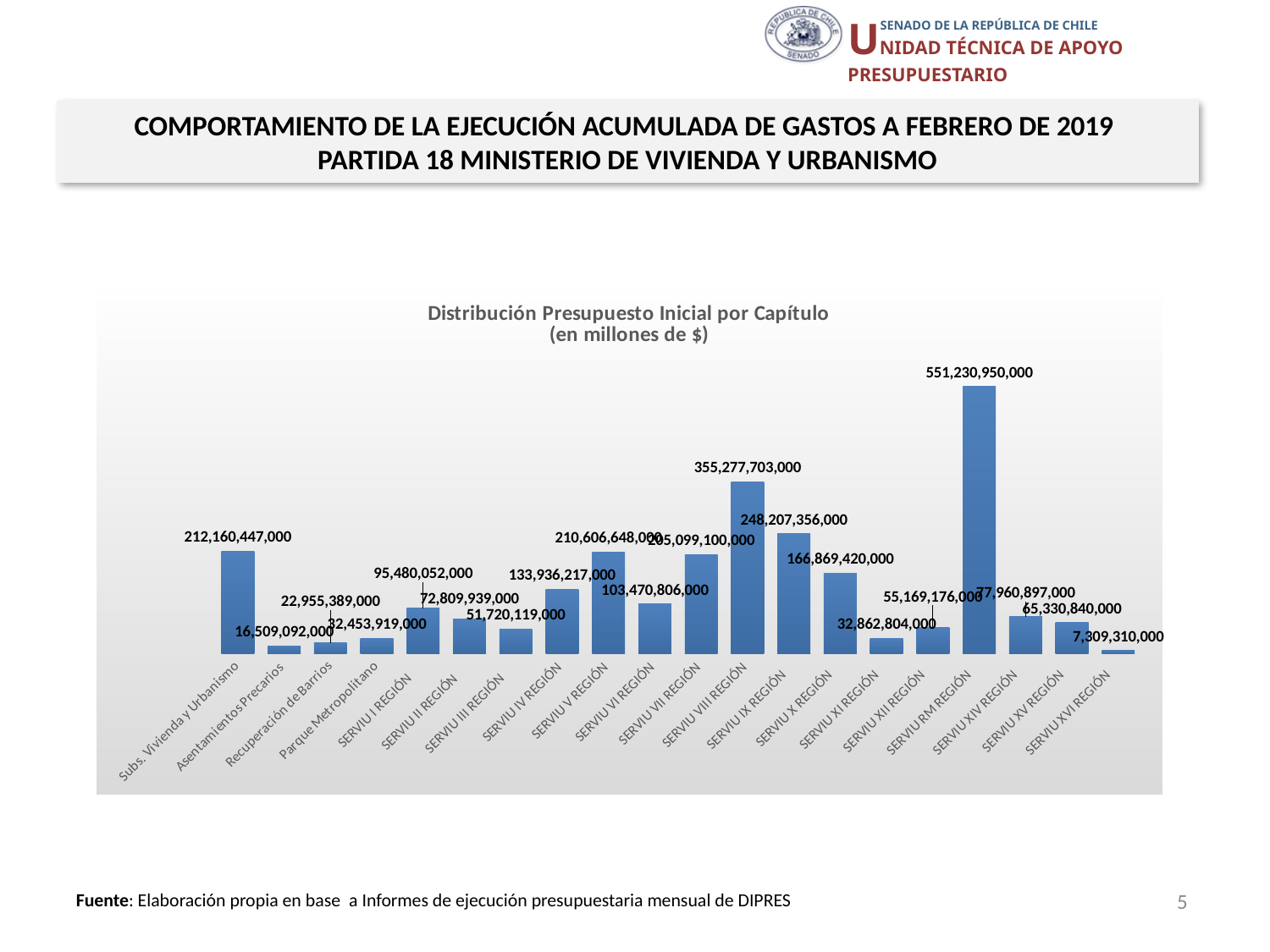
What is the difference between the values for SERVIU VIII REGIÓN and SERVIU IX REGIÓN? 107,070,347,000 What is the difference between the values for Subs. Vivienda y Urbanismo and Asentamientos Precarios? 195,651,355,000 Which category has the highest value? SERVIU RM REGIÓN Which category has the lowest value? SERVIU XVI REGIÓN What is the value for SERVIU RM REGIÓN? 551,230,950,000 What is the value for SERVIU X REGIÓN? 166,869,420,000 Which is larger, the value for SERVIU I REGIÓN or SERVIU II REGIÓN? SERVIU I REGIÓN How many categories are shown on the x axis? 20 What is the value for SERVIU VIII REGIÓN? 355,277,703,000 What is the value for Subs. Vivienda y Urbanismo? 212,160,447,000 What kind of chart is shown on the slide? Bar chart What is the value for SERVIU XVI REGIÓN? 7,309,310,000